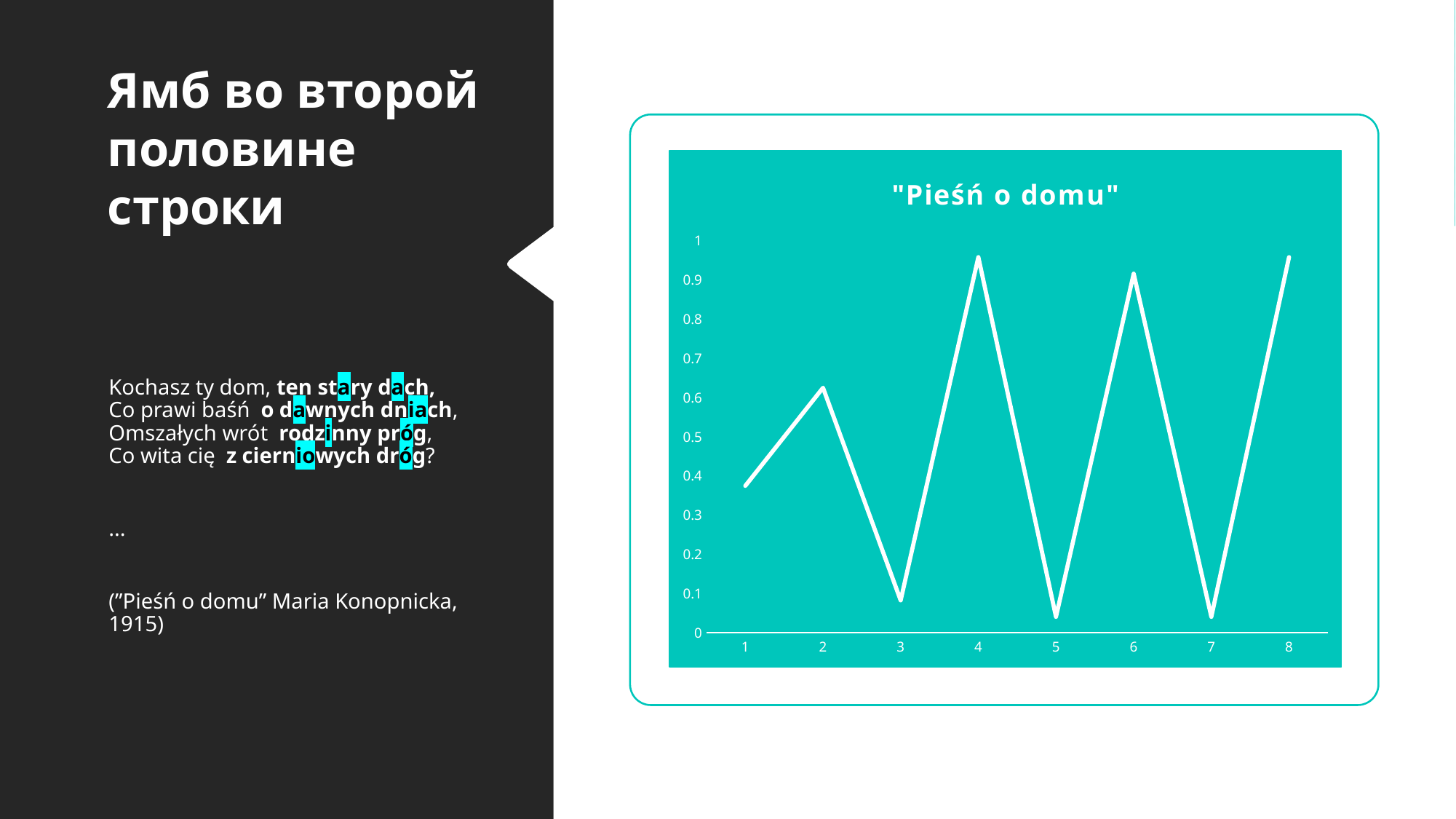
How many points are plotted along the x axis of the chart? 8 What kind of chart is shown on the slide? line chart Is the value at x = 1 greater or less than 0.5? less What is the title of the chart? "Pieśń o domu" Is the value at x = 5 greater or less than 0.1? less Which has the larger value, x = 1 or x = 4? 4 Is the value at x = 2 greater or less than 0.5? greater Which has the larger value, x = 2 or x = 3? 2 Does the line rise or fall between x = 1 and x = 2? rise